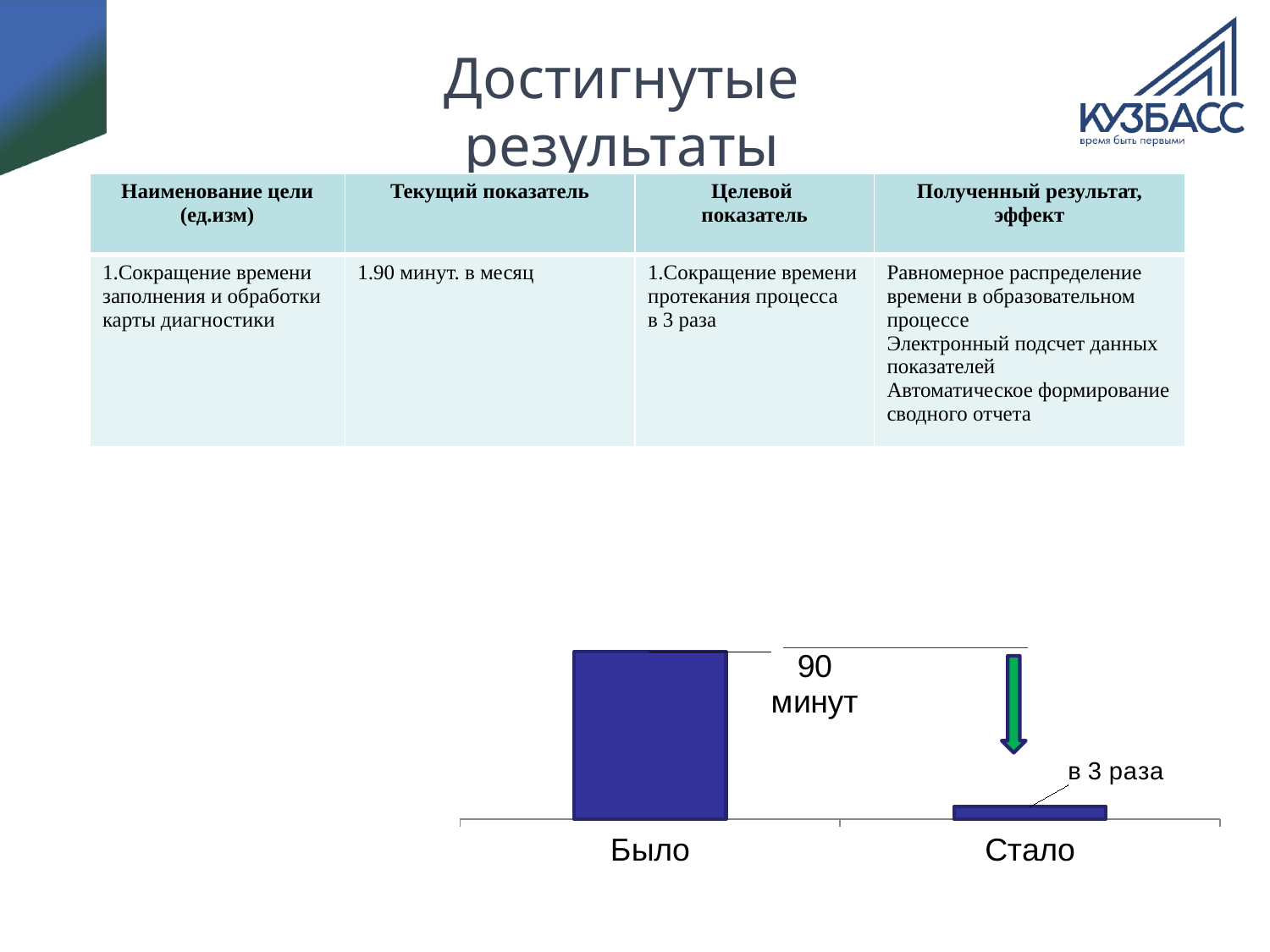
Which bar is taller, Было or Стало? Было Do the bar values rise or fall from Было to Стало? fall What kind of chart is shown at the bottom of the slide? bar chart What value is labelled on the bar for Было? 90 минут Which category has the highest bar in the chart? Было How many categories are shown on the x axis of the chart? 2 What label is attached to the Стало bar? в 3 раза Which category has the lowest bar in the chart? Стало What are the two category labels on the x axis of the chart? Было, Стало